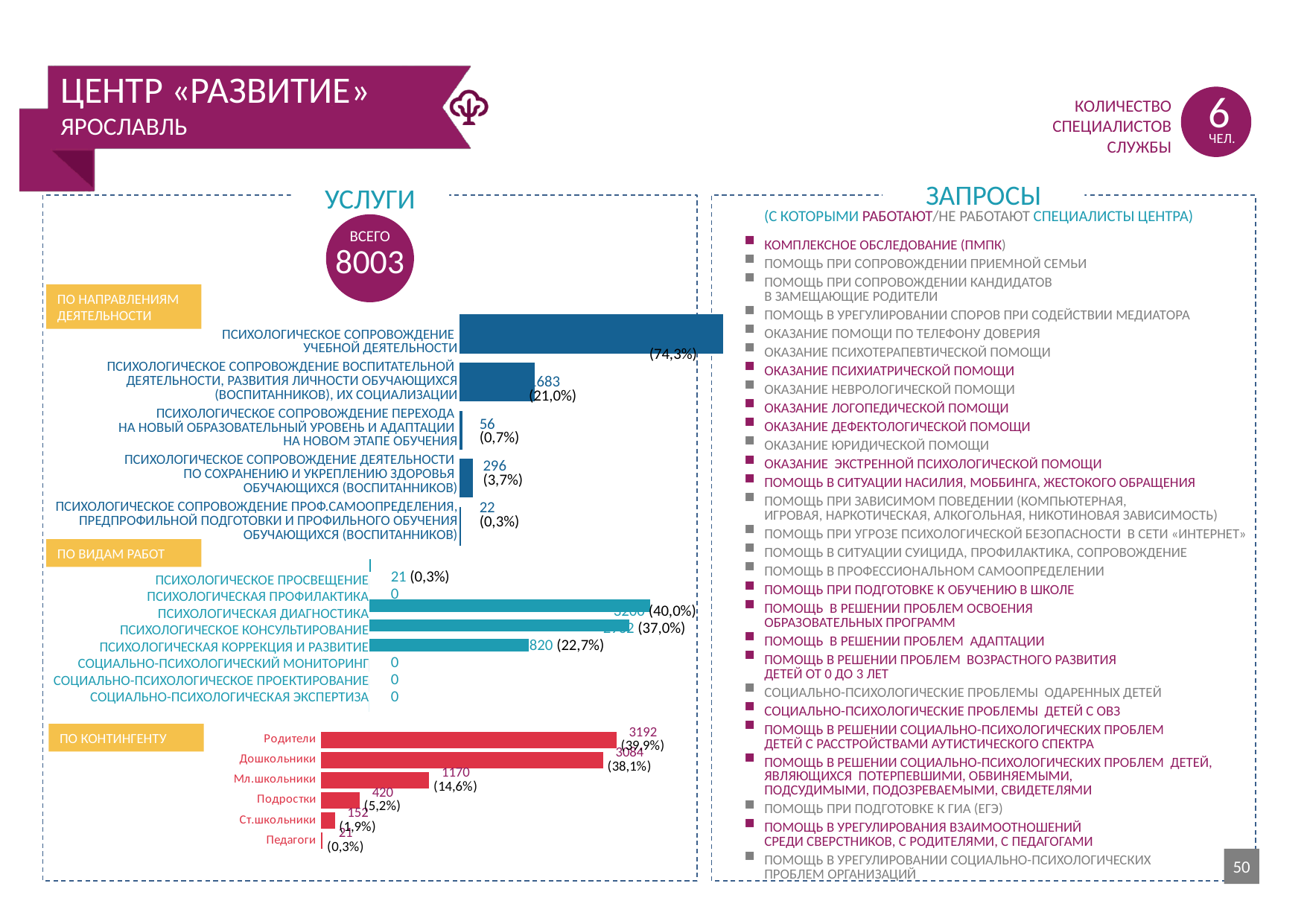
In the 'ПО КОНТИНГЕНТУ' chart, which is larger: Ст.школьники or Подростки? Подростки In the 'ПО КОНТИНГЕНТУ' chart, what is the difference between the values for Родители and Дошкольники? 108 In the 'ПО КОНТИНГЕНТУ' chart, what is the value for Родители? 3192 In the 'ПО КОНТИНГЕНТУ' chart, which category has the lowest value? Педагоги In the 'ПО КОНТИНГЕНТУ' chart, which category has the highest value? Родители How many categories are shown in the 'ПО КОНТИНГЕНТУ' chart? 6 In the 'ПО ВИДАМ РАБОТ' chart, how many categories have a value of 0? 4 In the 'ПО НАПРАВЛЕНИЯМ ДЕЯТЕЛЬНОСТИ' chart, what is the value for психологическое сопровождение деятельности по сохранению и укреплению здоровья обучающихся? 296 What type of chart is the 'ПО КОНТИНГЕНТУ' chart? bar chart In the 'ПО КОНТИНГЕНТУ' chart, what percentage is shown for Мл.школьники? 14,6% In the 'ПО НАПРАВЛЕНИЯМ ДЕЯТЕЛЬНОСТИ' chart, what percentage is shown for психологическое сопровождение учебной деятельности? 74,3% In the 'ПО КОНТИНГЕНТУ' chart, what is the value for Подростки? 420